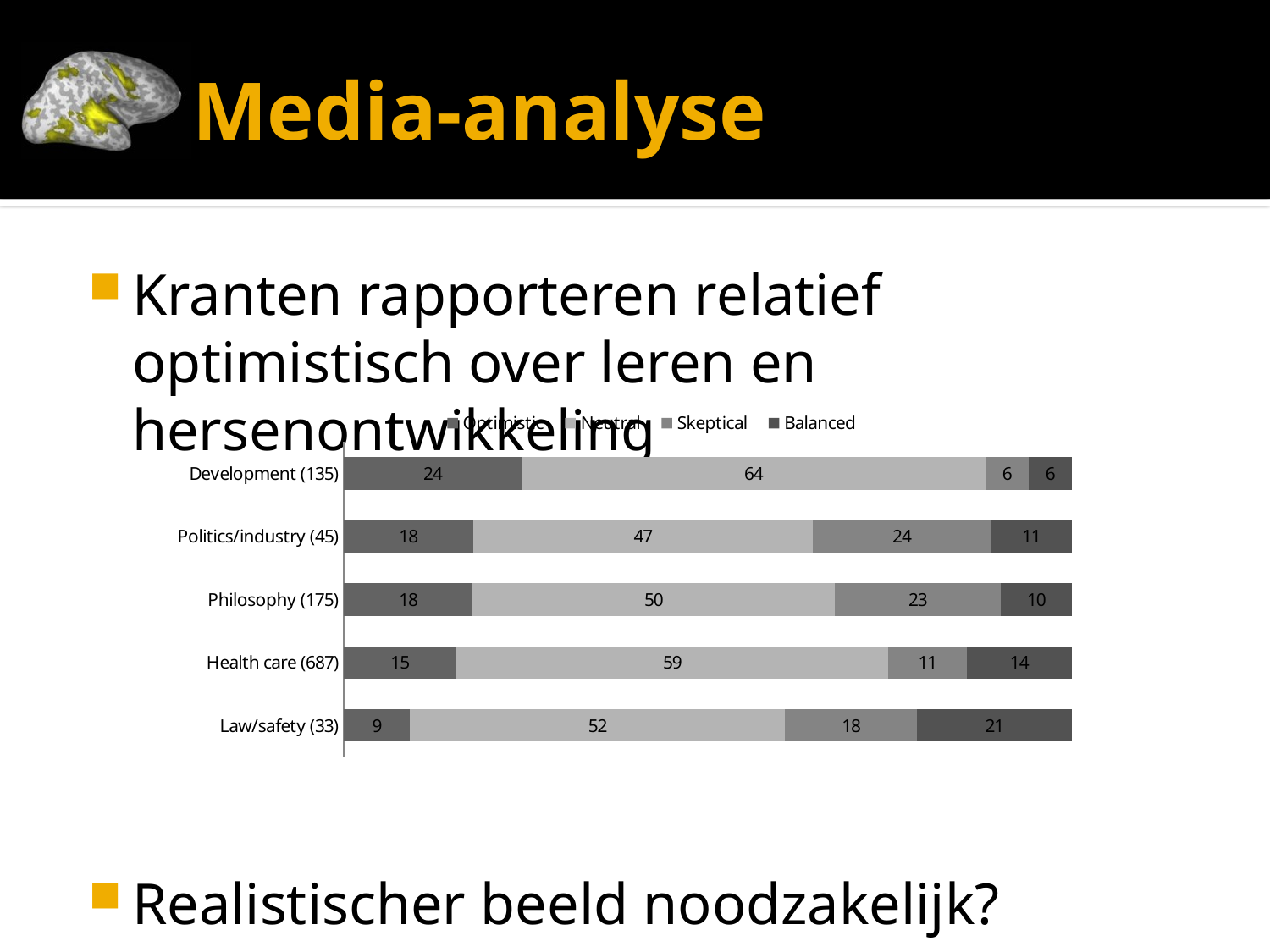
Which has the larger Neutral value, Health care (687) or Philosophy (175)? Health care (687) Which category has the highest Optimistic value? Development (135) What kind of chart is shown on the slide? Stacked bar chart How many categories are shown on the chart? 5 What is the difference between the Skeptical value for Politics/industry (45) and the Skeptical value for Health care (687)? 13 What is the Neutral value for Development (135)? 64 What is the Balanced value for Law/safety (33)? 21 What is the total of the stacked bar for Development (135)? 100 What are the four series listed in the chart's legend? Optimistic, Neutral, Skeptical, Balanced What is the Skeptical value for Philosophy (175)? 23 How many series does the chart's legend list? 4 Which category has the lowest Optimistic value? Law/safety (33)